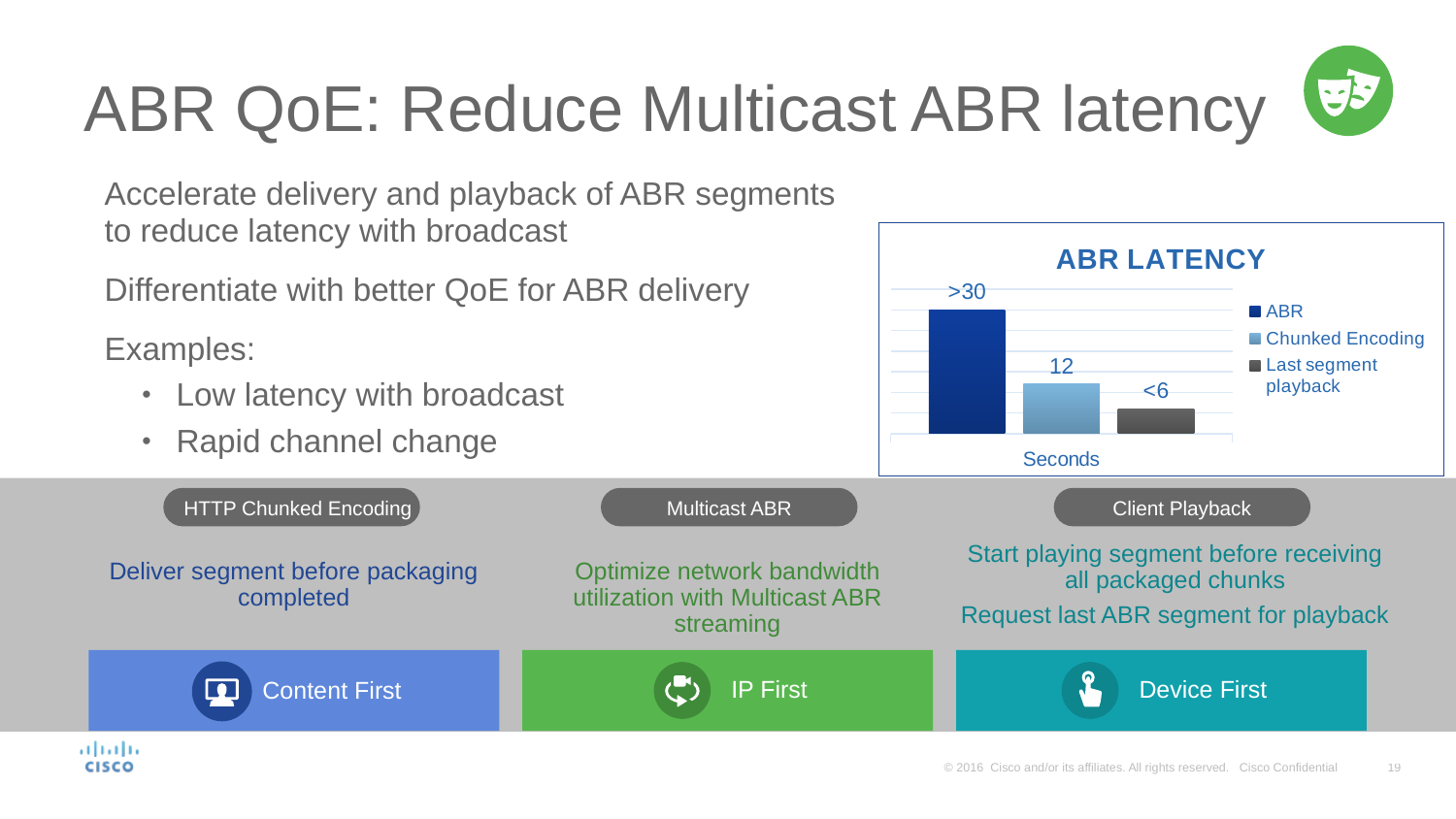
What is the data label shown for Last segment playback in the ABR LATENCY chart? <6 Which series has the highest value in the ABR LATENCY chart? ABR What type of chart is shown under the title ABR LATENCY? bar chart How many series does the legend of the ABR LATENCY chart list? 3 In the ABR LATENCY chart, which is larger: the value for Chunked Encoding or the value for Last segment playback? Chunked Encoding What is the value shown for Chunked Encoding in the ABR LATENCY chart? 12 What unit label appears on the x axis of the ABR LATENCY chart? Seconds What is the data label shown for the ABR series in the ABR LATENCY chart? >30 In the ABR LATENCY chart, which is larger: the value for ABR or the value for Chunked Encoding? ABR What is the title of the chart on the slide? ABR LATENCY Which series has the lowest value in the ABR LATENCY chart? Last segment playback How many bars are plotted in the ABR LATENCY chart? 3